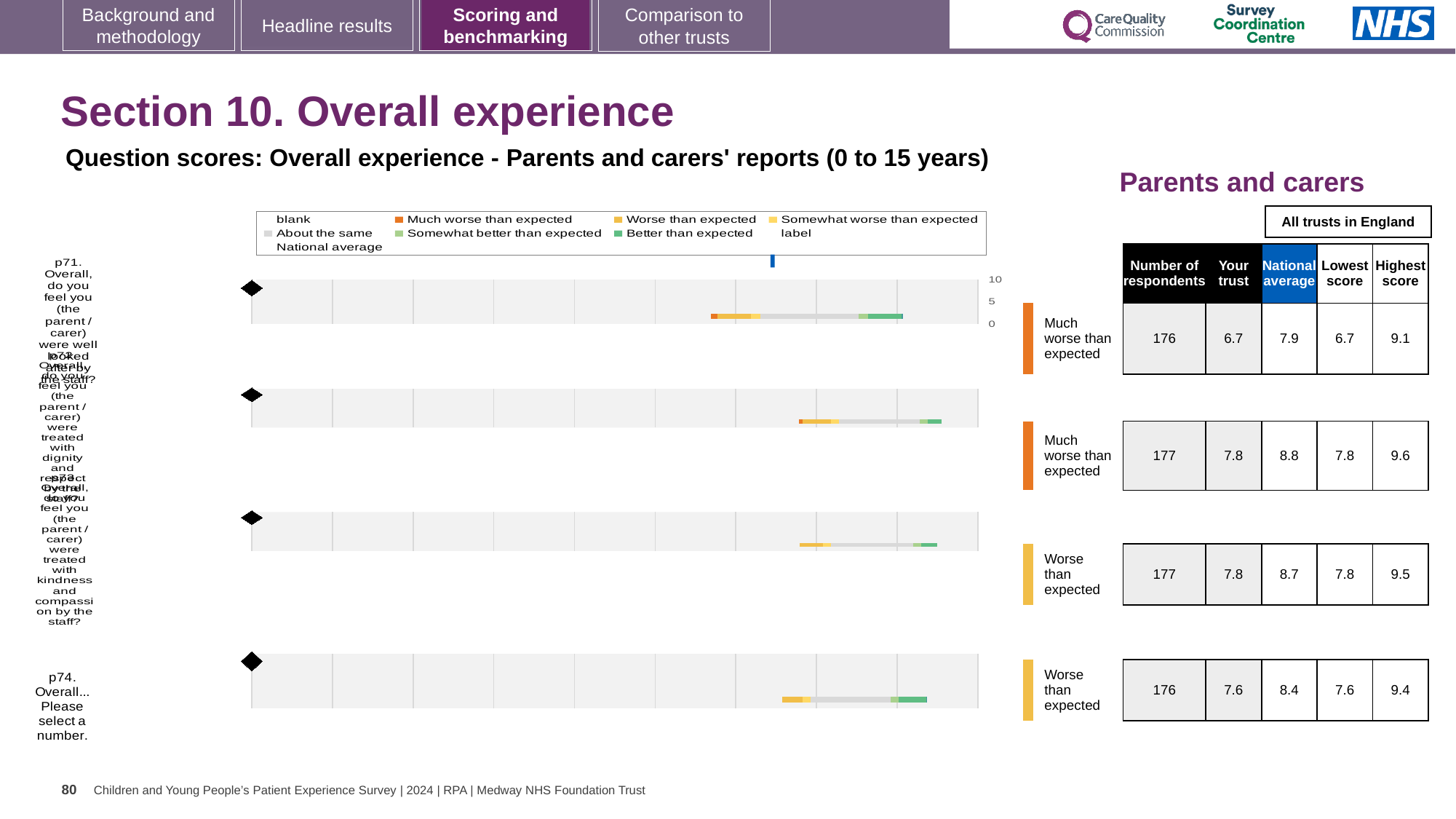
What benchmark category is shown for p74 (the bottom row of the chart)? Worse than expected How many respondents answered p74 (the bottom row of the chart)? 176 What is the national average for p71 (the top row of the chart)? 7.9 What benchmark category is shown for p71 (the top row of the chart)? Much worse than expected Which row of the chart has the lowest 'Your trust' score? p71 (top row) What is the highest score for p74 (the bottom row of the chart)? 9.4 How many questions (rows) are plotted in the chart? 4 What is the difference between the national average and the 'Your trust' score for p71 (the top row)? 1.2 What is the 'Your trust' score for p71 (the top row of the chart)? 6.7 For p71 (the top row), which is larger: the 'Your trust' score or the national average? National average What kind of chart is used to show the question scores on this slide? bar chart Which row of the chart has the highest 'Highest score' value? Second row from the top